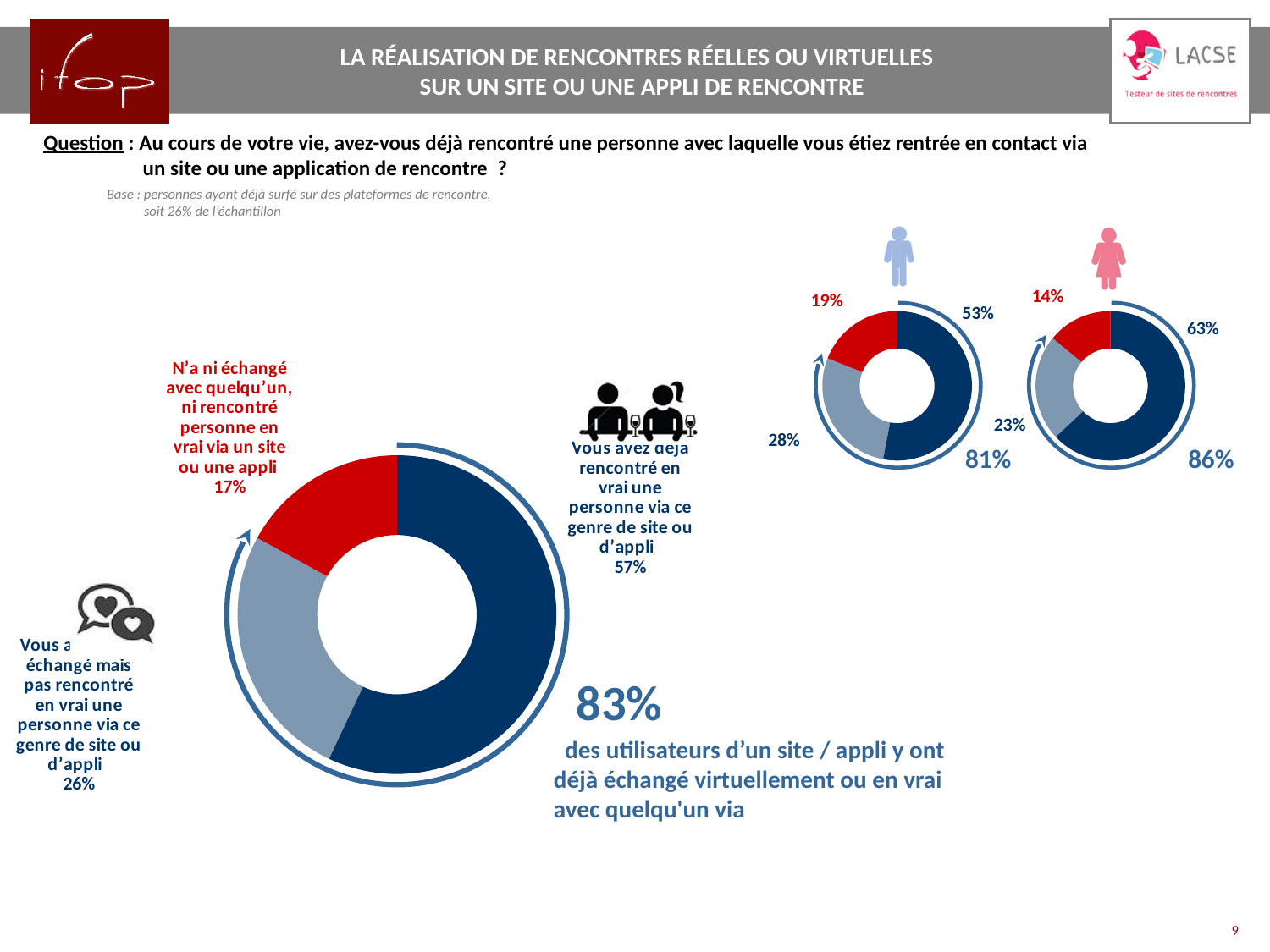
In the large donut chart, what is the difference in percentage points between those who met in person (57%) and those who only exchanged (26%)? 31 Which group has the higher share of people who have met someone in person: men (53%) or women (63%)? Women How many donut charts are shown on the slide? 3 In the small donut chart for women (pink figure), what percentage have already met someone in person? 63% What total percentage is shown next to the women's donut chart for those who have exchanged virtually or in person? 86% In the large donut chart, what percentage of respondents have already met in person someone via a dating site or app ("Vous avez déjà rencontré en vrai une personne")? 57% In the large donut chart, which category has the smallest share? N'a ni échangé avec quelqu'un, ni rencontré personne en vrai via un site ou une appli In the small donut chart for men (blue figure), what percentage have already met someone in person? 53% In the large donut chart, what percentage have exchanged but not met in person ("Vous avez échangé mais pas rencontré en vrai")? 26% In the large donut chart, what percentage have neither exchanged nor met anyone ("N'a ni échangé avec quelqu'un, ni rencontré personne")? 17% In the large donut chart, which category has the largest share? Vous avez déjà rencontré en vrai une personne via ce genre de site ou d'appli In the small donut chart for men, what percentage have neither exchanged nor met anyone (red slice)? 19%